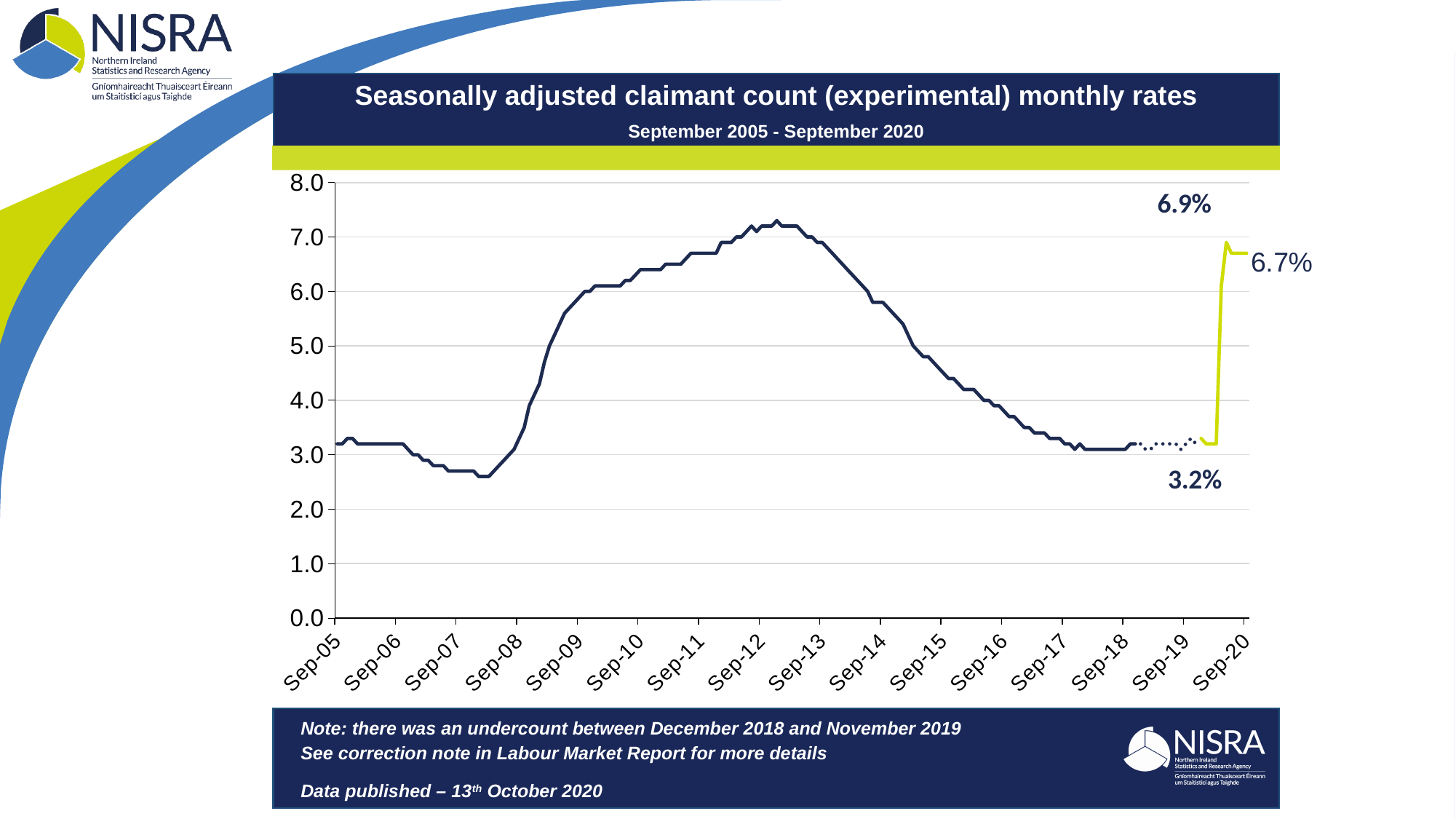
Is the value for Sep-05 greater or less than 4.0? less What is the claimant count rate labelled at the end of the series in September 2020? 6.7% Is the value for Sep-17 greater or less than 4.0? less Is the value for Sep-12 greater or less than 6.0? greater What kind of chart is shown on the slide? line chart What rate is labelled just before the sharp rise in 2020? 3.2% What is the difference between the 6.9% peak label and the 6.7% end label? 0.2 percentage points How many year labels are shown on the x axis? 16 What is the title of the chart? Seasonally adjusted claimant count (experimental) monthly rates What is the highest rate labelled on the 2020 portion of the line? 6.9% Does the line rise or fall between Sep-13 and Sep-17? fall What period does the chart cover, according to its subtitle? September 2005 - September 2020